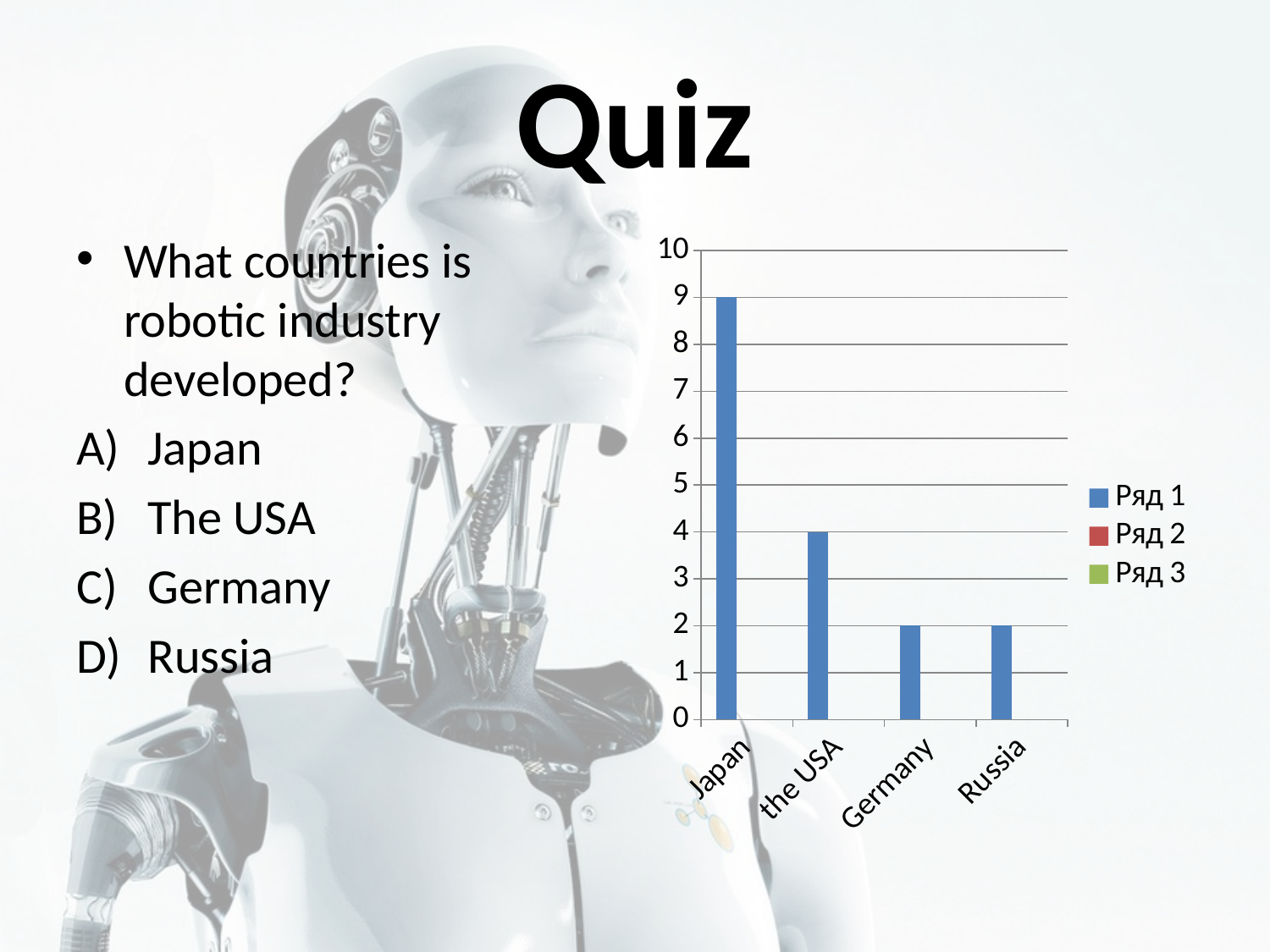
What is the value for Russia? 2 What is the value for Japan? 9 What is the value for Germany? 2 Which is larger, the value for the USA or the value for Germany? the USA How many series does the legend list? 3 How many countries are shown on the x axis? 4 What is the name of the first legend entry? Ряд 1 What is the difference between the values for Japan and the USA? 5 Is the value for Japan greater or less than 5? greater Which country has the highest bar? Japan What is the value for the USA? 4 What kind of chart is shown? bar chart